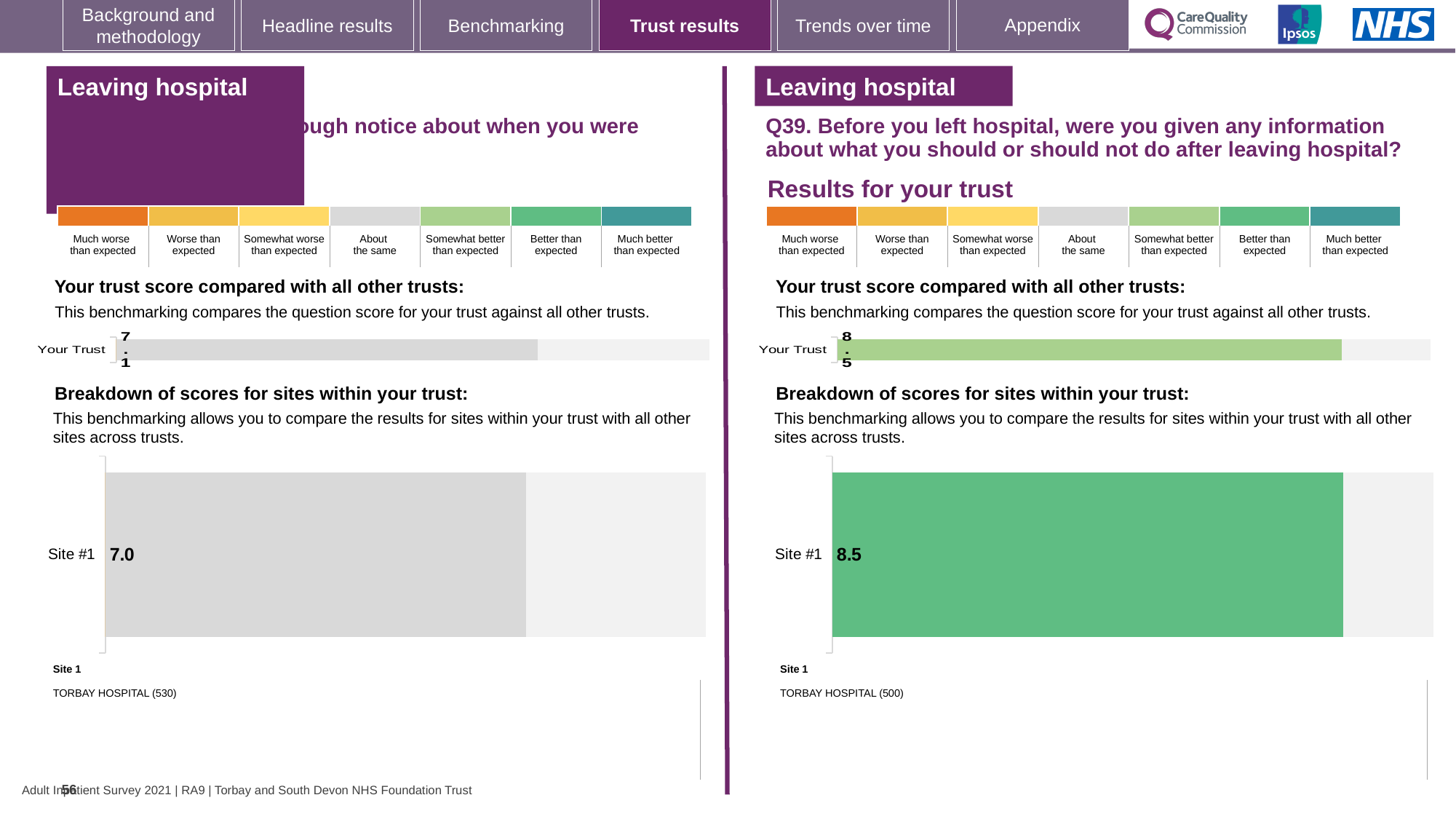
Which has the higher Site #1 score: the left-hand chart or the right-hand chart (Q39)? The right-hand chart (Q39) What is the difference between the 'Your Trust' score on the right-hand side (Q39) and the 'Your Trust' score on the left-hand side? 1.4 On the left-hand side of the slide, what is the 'Your Trust' score shown in the trust comparison bar? 7.1 What type of chart is used to show the Site #1 score on the right-hand side (Q39)? Bar chart On the left-hand side of the slide, how many respondents are shown in brackets for TORBAY HOSPITAL (Site 1)? 530 How many sites are shown in the breakdown of scores on the right-hand side (Q39)? 1 On the right-hand side (Q39), which benchmark category does the colour of the Site #1 bar correspond to in the legend? Better than expected On the right-hand side (Q39), what is the 'Your Trust' score shown in the trust comparison bar? 8.5 What is the difference between the Site #1 score on the right-hand chart (Q39) and the Site #1 score on the left-hand chart? 1.5 On the right-hand side (Q39), what score is shown for Site #1 in the breakdown of scores for sites? 8.5 On the right-hand side (Q39), which hospital is listed as Site 1 and how many respondents are shown in brackets? TORBAY HOSPITAL (500) On the left-hand side of the slide, what score is shown for Site #1 in the breakdown of scores for sites? 7.0